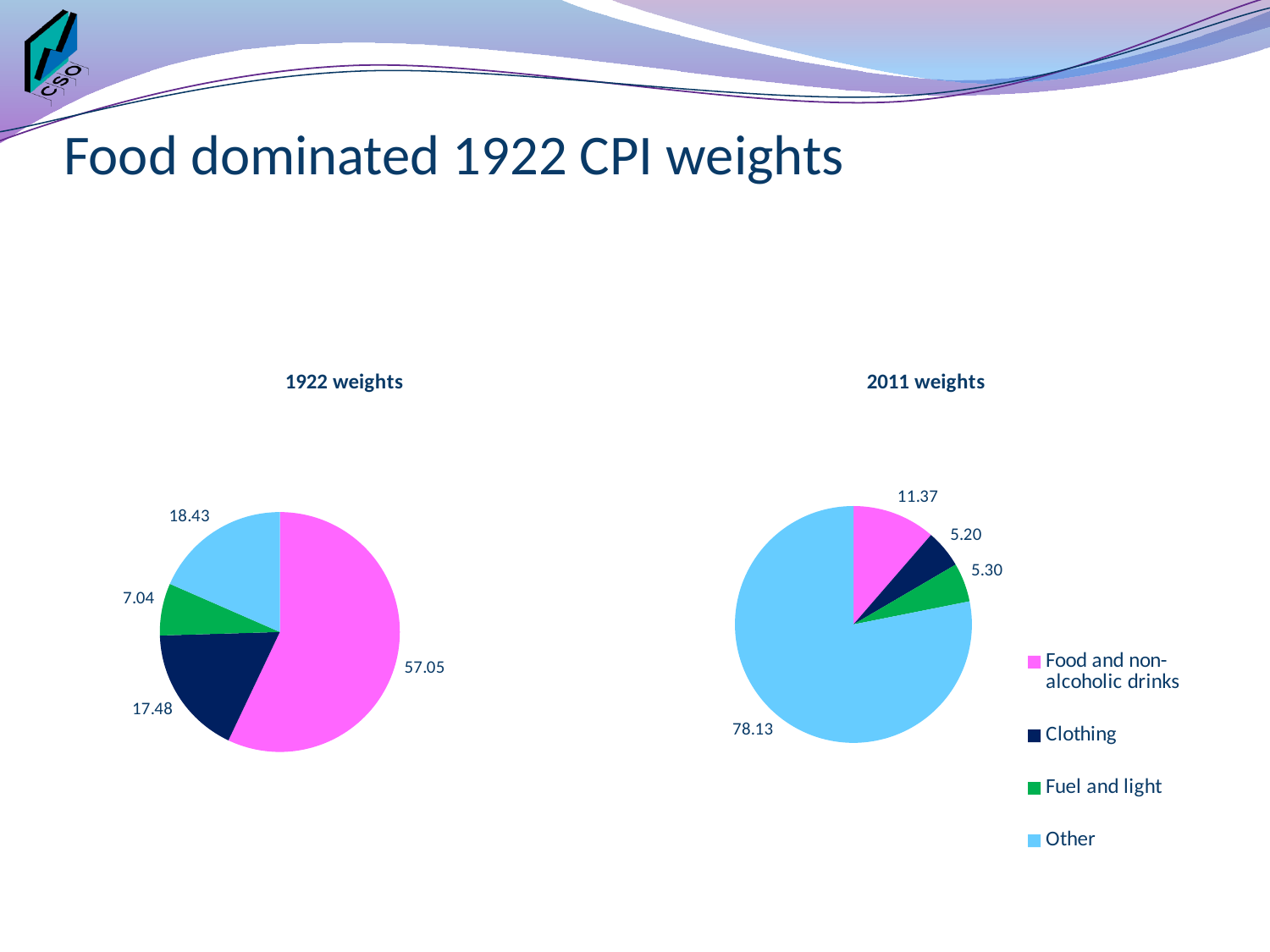
Which colour represents Fuel and light in the legend? Green In the 1922 weights chart, what is the value for Food and non-alcoholic drinks? 57.05 In the 1922 weights chart, which is larger: Other or Clothing? Other In the 1922 weights chart, which category has the largest slice? Food and non-alcoholic drinks How many slices does the 2011 weights pie chart have? 4 In the 2011 weights chart, what is the value for Fuel and light? 5.30 In the 2011 weights chart, which category has the smallest slice? Clothing What is the difference between the Food and non-alcoholic drinks value in the 1922 weights chart and in the 2011 weights chart? 45.68 In the 2011 weights chart, what is the value for Other? 78.13 In the 1922 weights chart, what is the value for Clothing? 17.48 What type of chart is used for the 1922 weights? Pie chart In the 1922 weights chart, which category has the smallest slice? Fuel and light